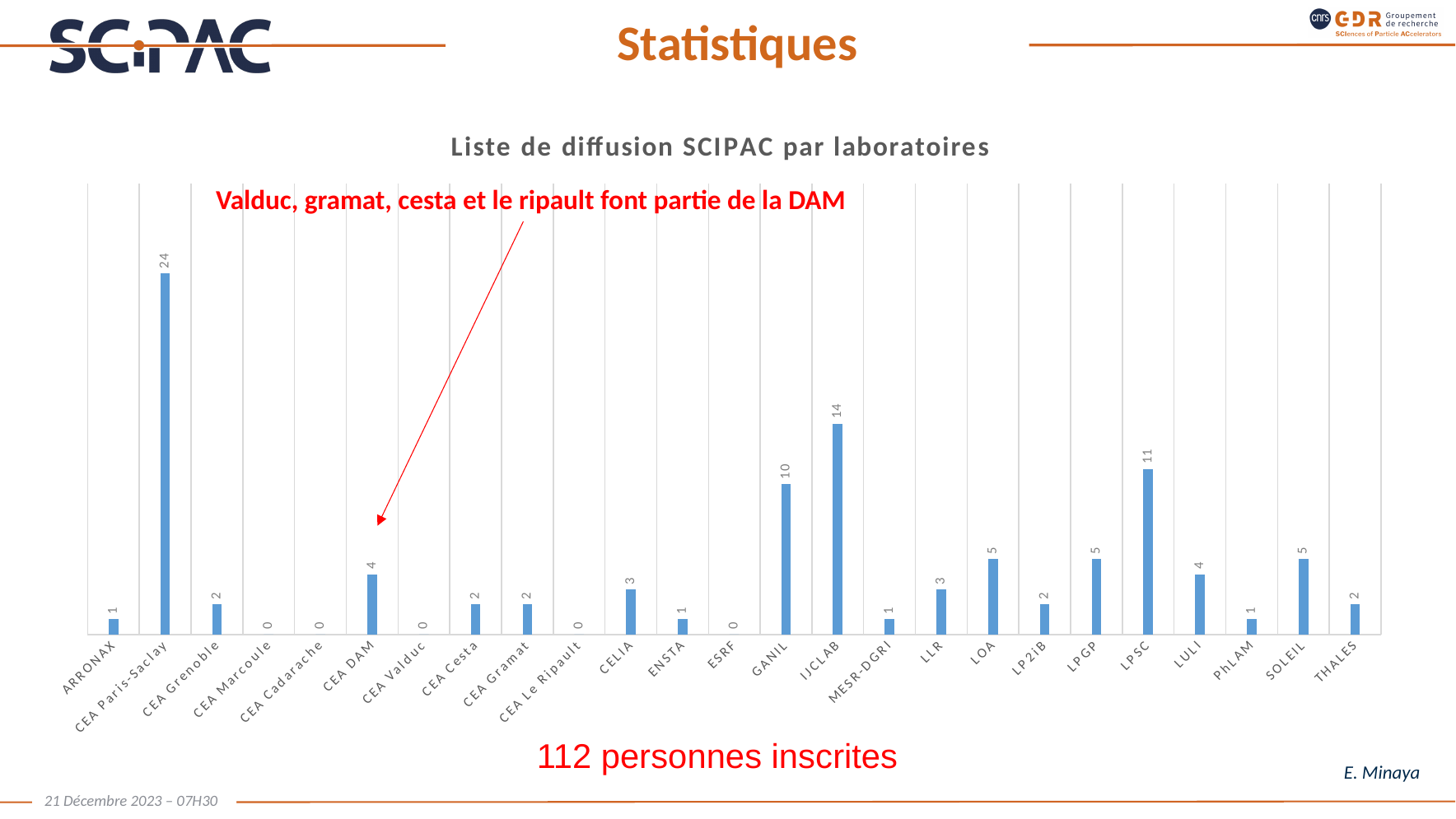
What is the value for GANIL? 10 What kind of chart is shown on the slide? Bar chart What is the value for CEA Paris-Saclay? 24 How many laboratories are shown on the x axis? 25 What is the difference between the values for CEA Paris-Saclay and IJCLAB? 10 Which laboratory has the highest value? CEA Paris-Saclay What is the value for LPSC? 11 What is the value for CEA DAM? 4 What is the value for IJCLAB? 14 What is the title of the chart? Liste de diffusion SCIPAC par laboratoires What is the difference between the values for LPSC and GANIL? 1 Which is larger, the value for LOA or the value for LULI? LOA